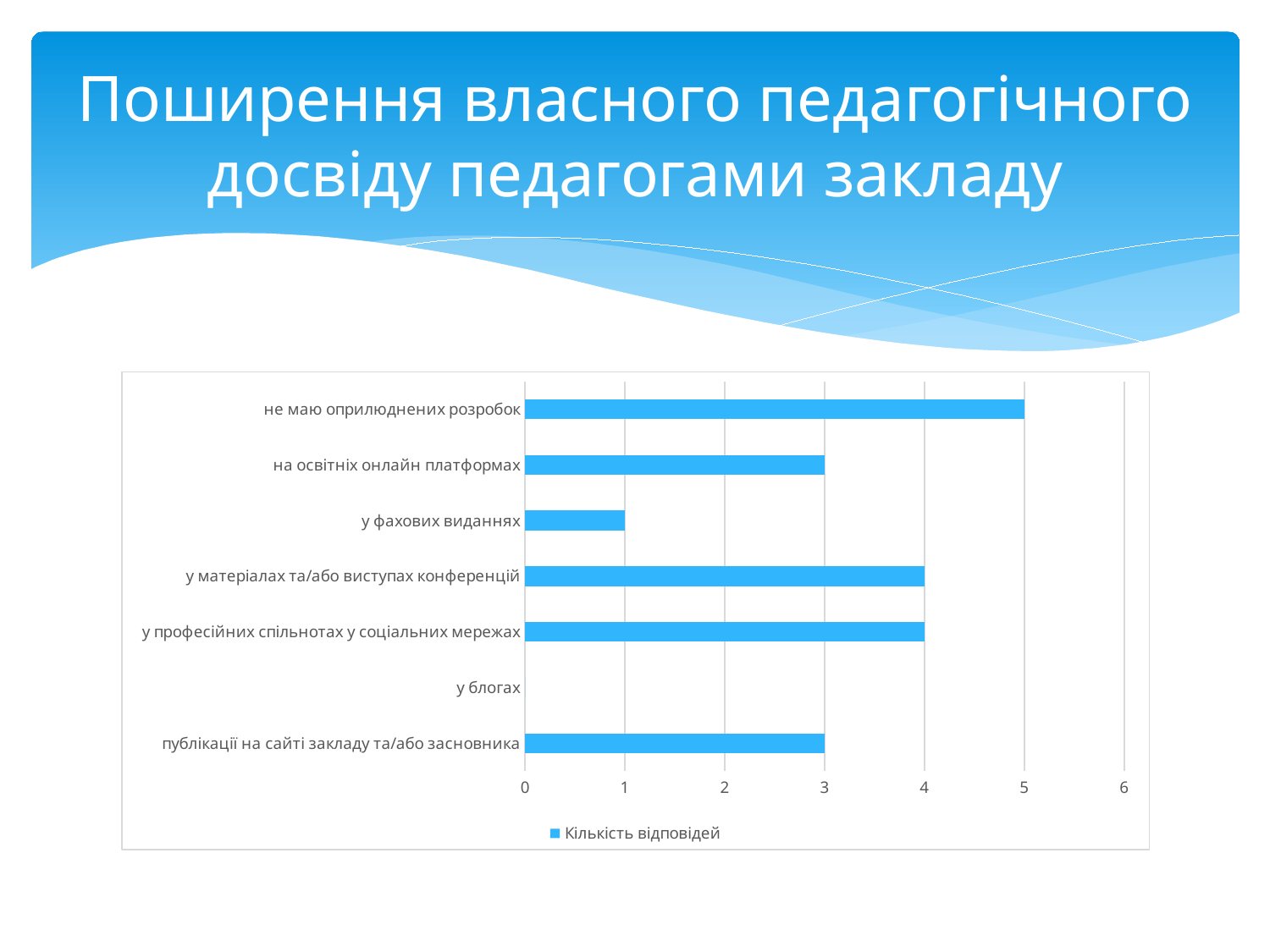
What is the value for "не маю оприлюднених розробок"? 5 What is the value for "на освітніх онлайн платформах"? 3 What is the name of the series shown in the legend? Кількість відповідей Which category has the lowest value? у блогах What is the value for "у фахових виданнях"? 1 What is the difference between the values for "не маю оприлюднених розробок" and "у фахових виданнях"? 4 How many series does the legend list? 1 Which is larger, the value for "у матеріалах та/або виступах конференцій" or the value for "публікації на сайті закладу та/або засновника"? у матеріалах та/або виступах конференцій What kind of chart is shown on the slide? bar chart How many categories does the chart show? 7 Which category has the highest value? не маю оприлюднених розробок Is the value for "у професійних спільнотах у соціальних мережах" greater or less than 2? greater